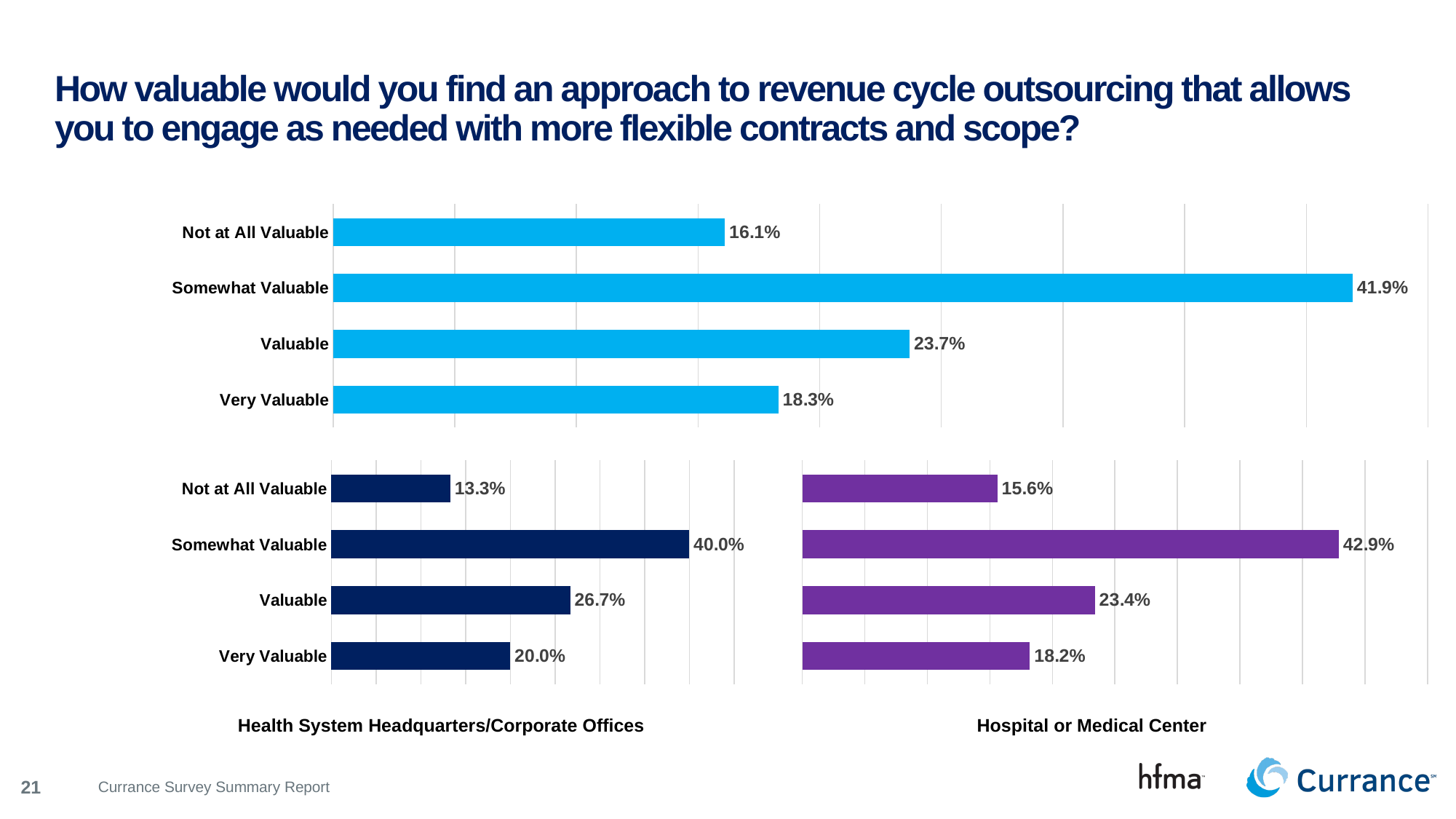
What kind of chart is the top chart? Bar chart What is the title of the bottom-right chart? Hospital or Medical Center In the Health System Headquarters/Corporate Offices chart, what is the difference between Somewhat Valuable and Very Valuable? 20.0% How many categories are shown in the Hospital or Medical Center chart? 4 In the top chart, what is the value for Somewhat Valuable? 41.9% In the Hospital or Medical Center chart, what is the value for Not at All Valuable? 15.6% Which is larger: Very Valuable in the Health System Headquarters/Corporate Offices chart or Very Valuable in the Hospital or Medical Center chart? Health System Headquarters/Corporate Offices In the Health System Headquarters/Corporate Offices chart, what is the value for Valuable? 26.7% In the Health System Headquarters/Corporate Offices chart, which category has the lowest value? Not at All Valuable In the Hospital or Medical Center chart, which category has the highest value? Somewhat Valuable In the top chart, what is the value for Very Valuable? 18.3% In the top chart, what is the difference between Somewhat Valuable and Valuable? 18.2%